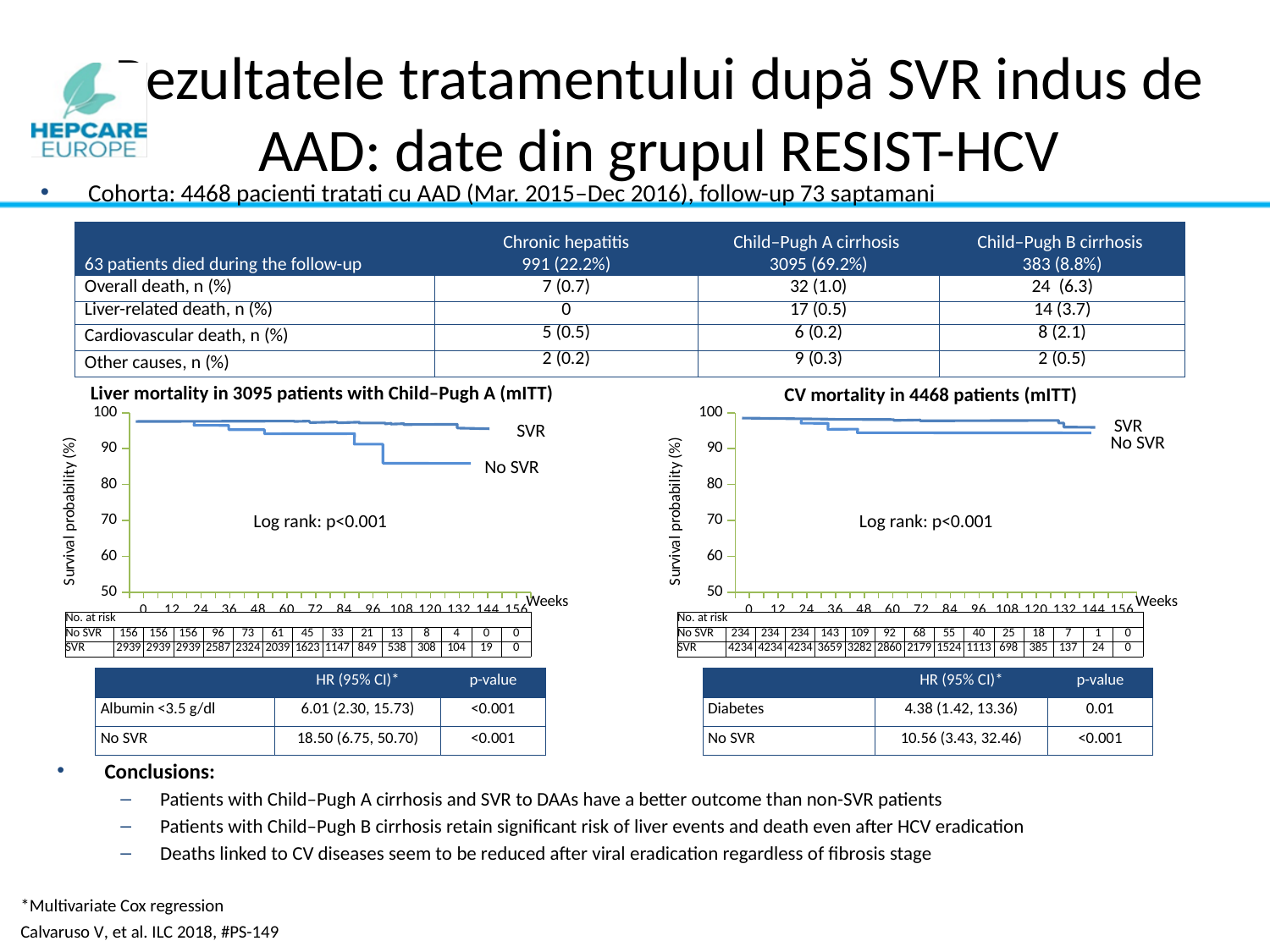
In the 'CV mortality in 4468 patients (mITT)' chart, is the No SVR survival probability at week 144 greater or less than 90? greater In the 'Liver mortality in 3095 patients with Child–Pugh A (mITT)' chart, which series has the higher survival probability at week 120, SVR or No SVR? SVR In the 'CV mortality in 4468 patients (mITT)' chart, which series has the higher survival probability at week 60, SVR or No SVR? SVR What is the label on the y axis of the 'CV mortality in 4468 patients (mITT)' chart? Survival probability (%) How many tick labels are shown on the x axis (Weeks) of the 'CV mortality in 4468 patients (mITT)' chart? 14 In the 'Liver mortality in 3095 patients with Child–Pugh A (mITT)' chart, is the No SVR survival probability at week 120 greater or less than 90? less How many series are plotted in the 'CV mortality in 4468 patients (mITT)' chart? 2 In the 'Liver mortality in 3095 patients with Child–Pugh A (mITT)' chart, is the SVR survival probability at week 156 greater or less than 90? greater In the 'Liver mortality in 3095 patients with Child–Pugh A (mITT)' chart, does the No SVR curve rise or fall as weeks increase? Fall What kind of chart is the 'Liver mortality in 3095 patients with Child–Pugh A (mITT)' chart? Line chart What is the lowest value shown on the y axis of the 'Liver mortality in 3095 patients with Child–Pugh A (mITT)' chart? 50 In the 'Liver mortality in 3095 patients with Child–Pugh A (mITT)' chart, what are the two series labelled? SVR and No SVR